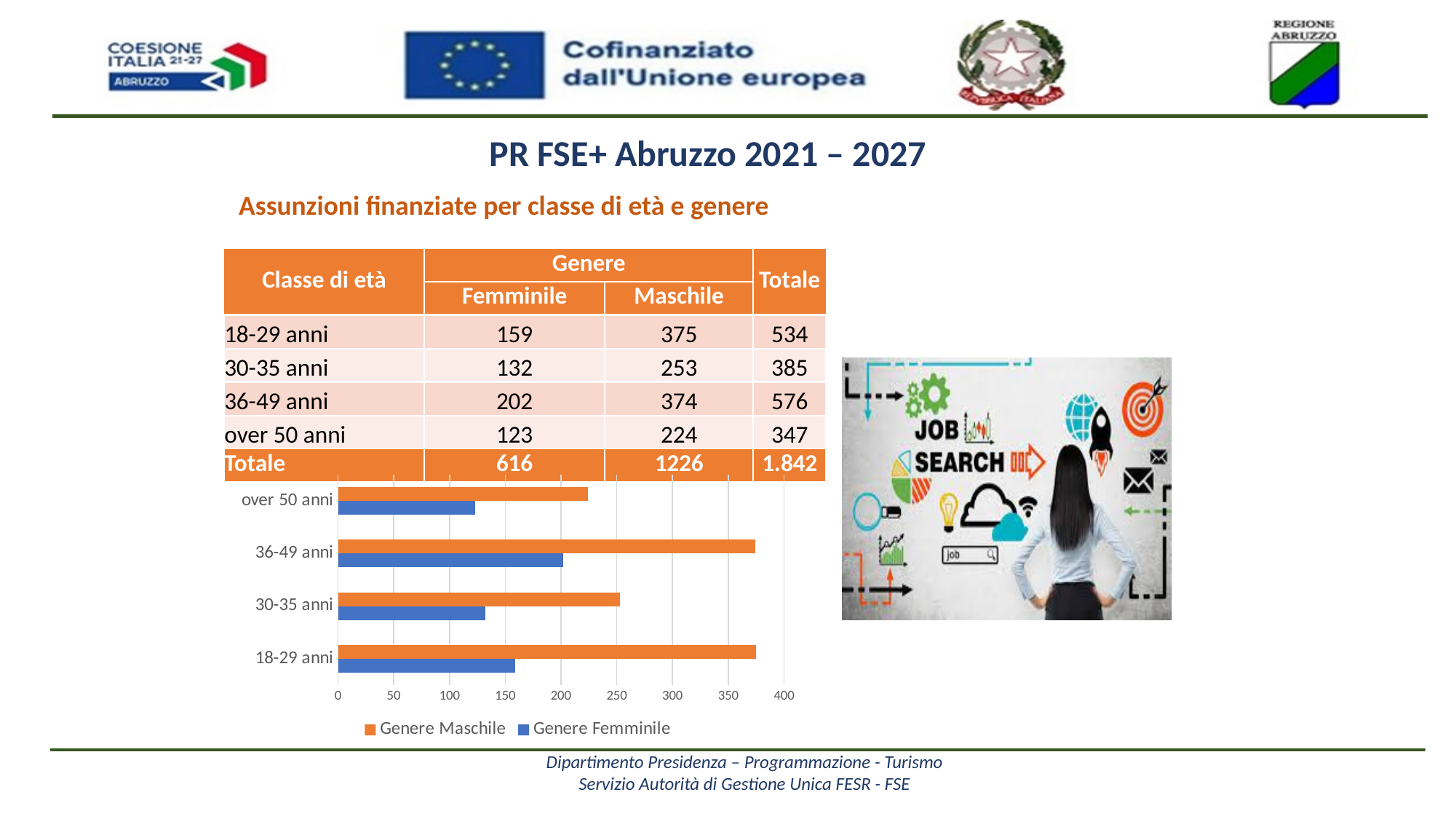
What is the value for Genere Femminile in the 36-49 anni class? 202 In the 30-35 anni class, which is larger: Genere Maschile or Genere Femminile? Genere Maschile What kind of chart is shown on the slide? bar chart Is the value for Genere Maschile in the 18-29 anni class greater or less than 350? greater How many series does the chart legend list? 2 How many age classes are plotted in the bar chart? 4 What is the difference between Genere Maschile and Genere Femminile in the over 50 anni class? 101 Which age class has the highest value for Genere Femminile? 36-49 anni Which age class has the lowest value for Genere Femminile? over 50 anni Which age class has the lowest value for Genere Maschile? over 50 anni What is the value for Genere Maschile in the 30-35 anni class? 253 Which series is shown in orange in the chart? Genere Maschile